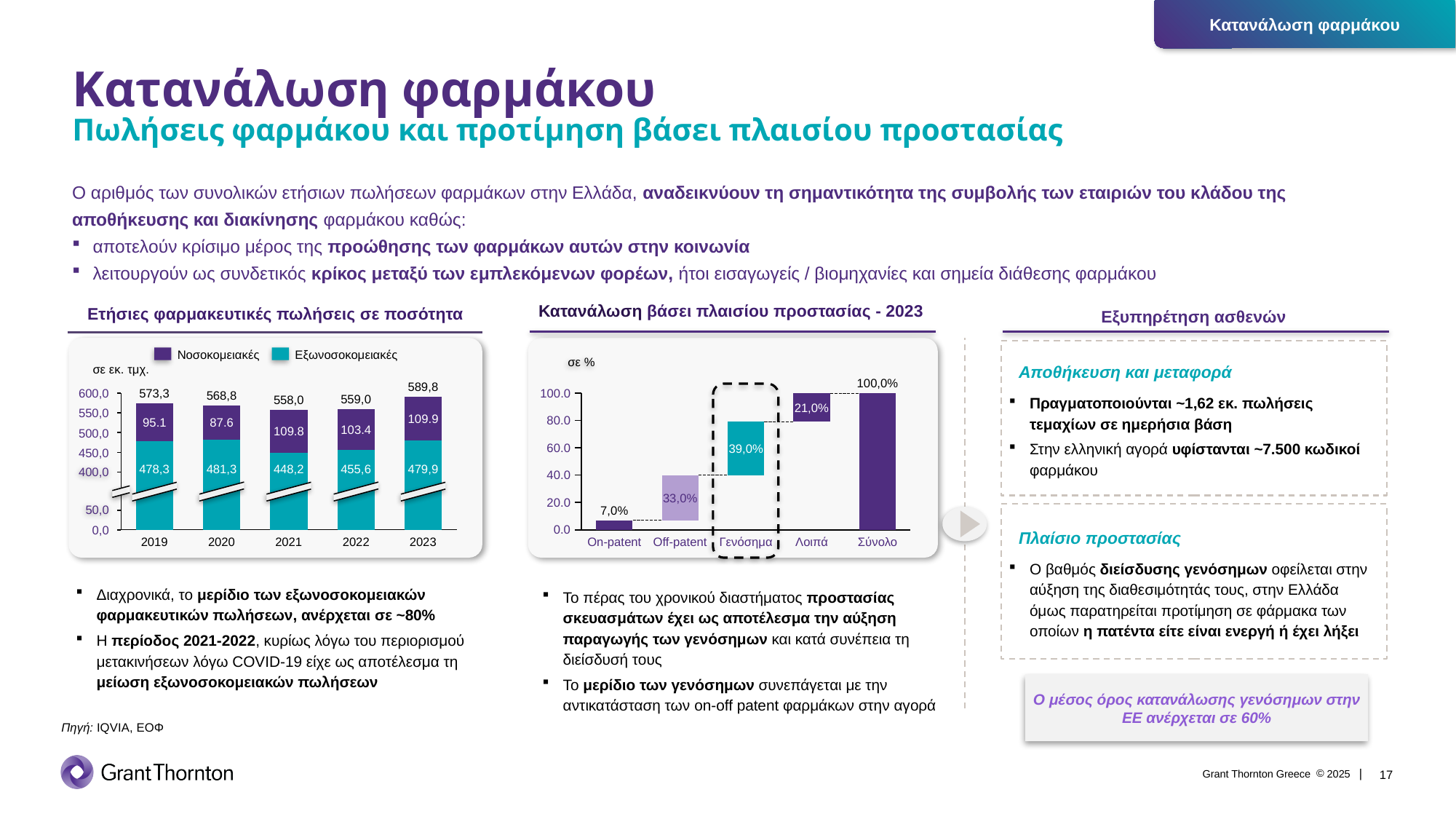
In the chart 'Ετήσιες φαρμακευτικές πωλήσεις σε ποσότητα', what is the total value shown above the bar for 2023? 589,8 In the chart 'Κατανάλωση βάσει πλαισίου προστασίας - 2023', which category is larger, Off-patent or Λοιπά? Off-patent In the chart 'Κατανάλωση βάσει πλαισίου προστασίας - 2023', what is the value for On-patent? 7,0% In the chart 'Ετήσιες φαρμακευτικές πωλήσεις σε ποσότητα', what is the Νοσοκομειακές value for 2020? 87.6 In the chart 'Ετήσιες φαρμακευτικές πωλήσεις σε ποσότητα', how many years are shown on the x axis? 5 In the chart 'Κατανάλωση βάσει πλαισίου προστασίας - 2023', what is the value for Γενόσημα? 39,0% In the chart 'Ετήσιες φαρμακευτικές πωλήσεις σε ποσότητα', what is the difference between the total for 2023 and the total for 2022? 30,8 In the chart 'Ετήσιες φαρμακευτικές πωλήσεις σε ποσότητα', what is the Εξωνοσοκομειακές value for 2021? 448,2 In the chart 'Ετήσιες φαρμακευτικές πωλήσεις σε ποσότητα', how many series does the legend list? 2 In the chart 'Κατανάλωση βάσει πλαισίου προστασίας - 2023', what kind of chart is shown? Bar chart In the chart 'Ετήσιες φαρμακευτικές πωλήσεις σε ποσότητα', which year has the lowest total? 2021 In the chart 'Ετήσιες φαρμακευτικές πωλήσεις σε ποσότητα', which year has the highest total? 2023